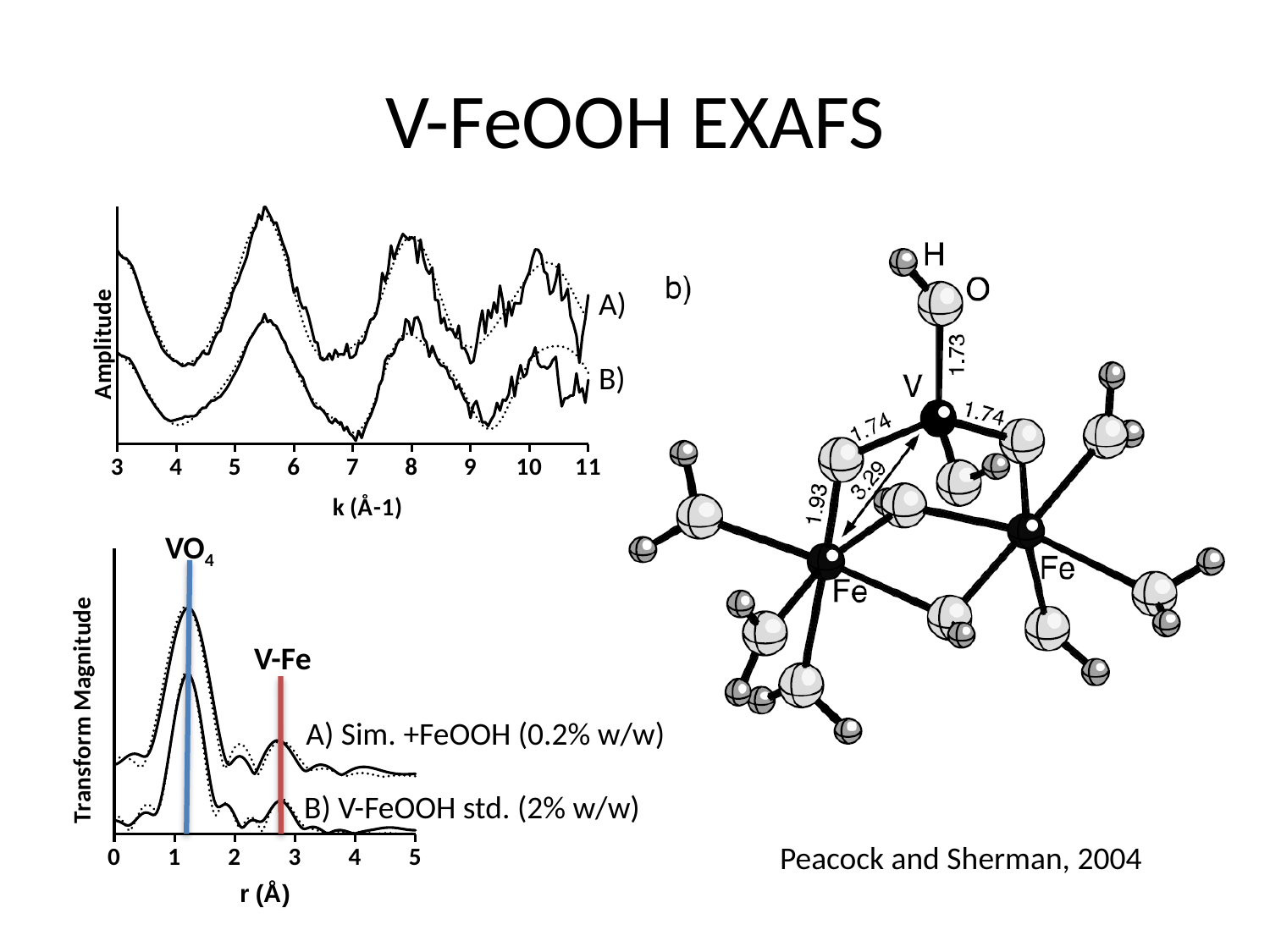
In the bottom chart, is the r position of the peak marked VO4 greater or less than 2? less In the top chart, is the k position of the tallest peak of trace A greater or less than 5? greater In the bottom chart, how many labelled traces are plotted? 2 In the bottom chart, is the r position of the peak marked V-Fe greater or less than 3? less What kind of chart is the bottom chart (Transform Magnitude vs r)? line chart In the bottom chart, what is the label of trace A? A) Sim. +FeOOH (0.2% w/w) What kind of chart is the top chart (Amplitude vs k)? line chart In the bottom chart, which peak is taller, the one marked VO4 or the one marked V-Fe? VO4 In the top chart, how many labelled traces are plotted? 2 In the top chart, what is the highest value shown on the x axis? 11